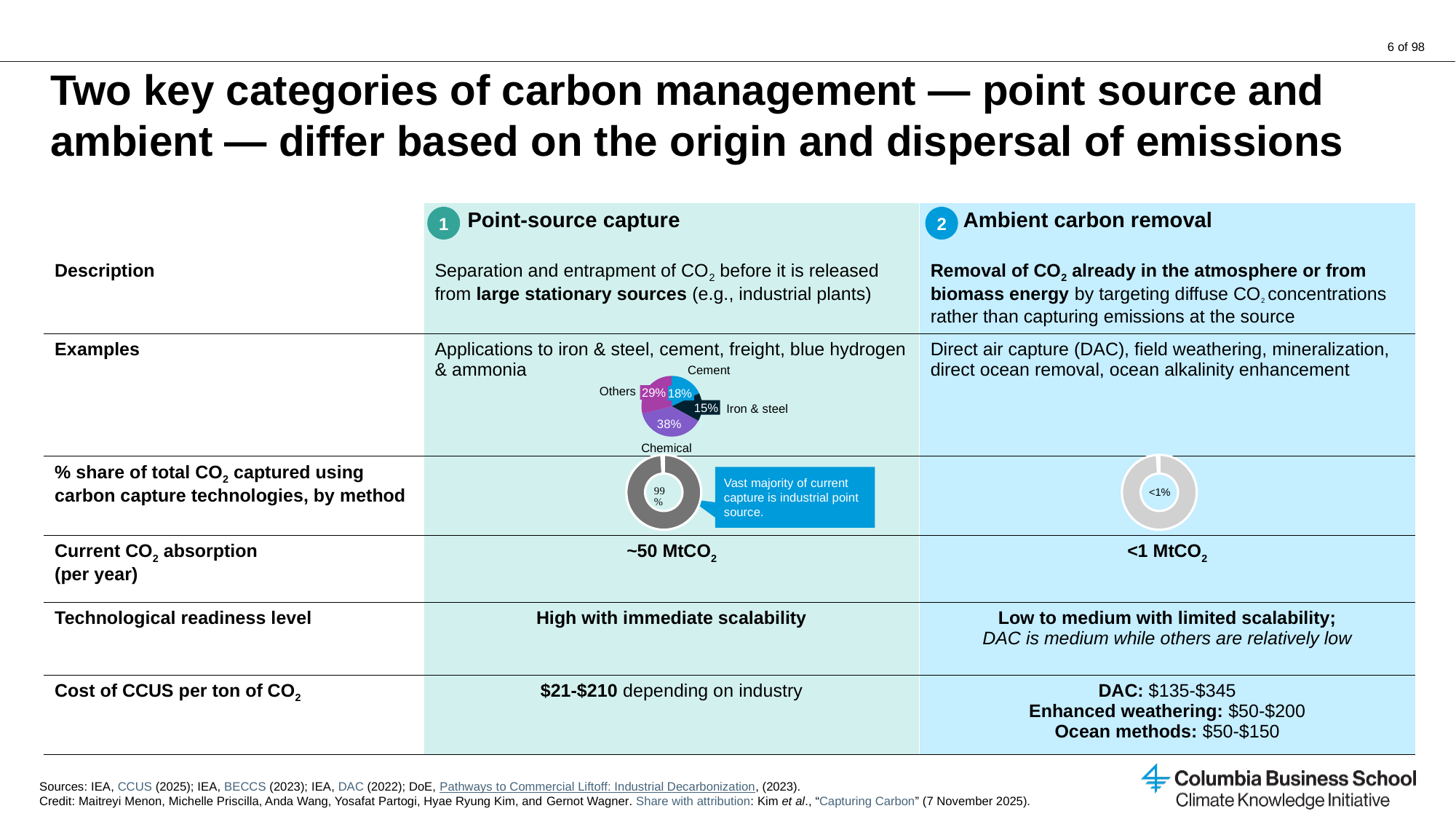
How many categories does the pie chart under Point-source capture examples show? 4 In the pie chart under Point-source capture examples, what share is shown for Cement? 18% In the donut chart for % share of total CO2 captured, what value is shown for Ambient carbon removal? <1% In the pie chart under Point-source capture examples, how many percentage points larger is Chemical than Cement? 20 percentage points In the pie chart under Point-source capture examples, which category has the largest share? Chemical In the pie chart under Point-source capture examples, which is larger, Others or Cement? Others In the pie chart under Point-source capture examples, what share is shown for Iron & steel? 15% What kind of chart is shown under the Point-source capture examples? Pie chart In the pie chart under Point-source capture examples, which category has the smallest share? Iron & steel In the pie chart under Point-source capture examples, what share is shown for Chemical? 38% In the donut chart for % share of total CO2 captured, what value is shown for Point-source capture? 99% In the pie chart under Point-source capture examples, what share is shown for Others? 29%